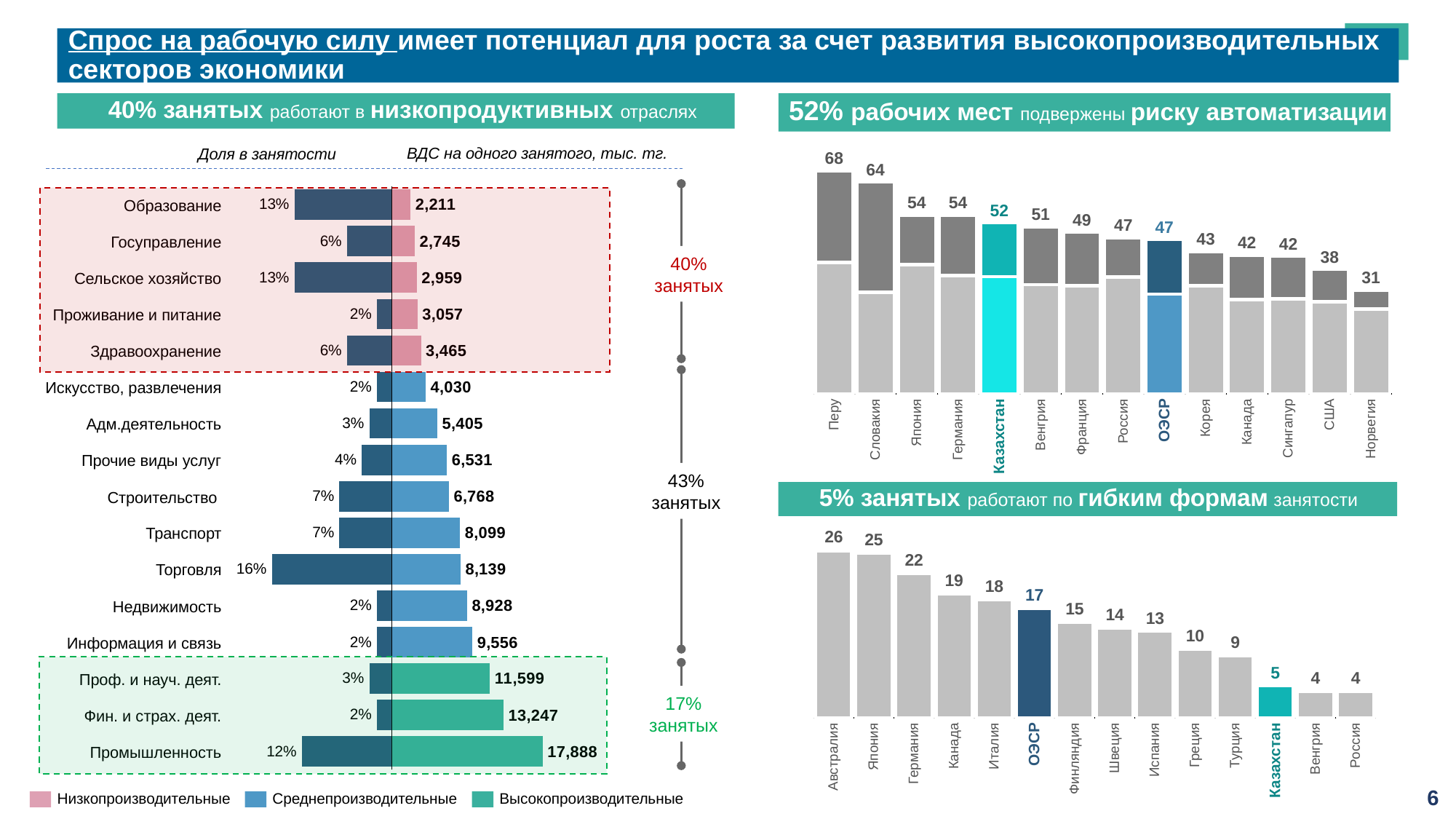
On the chart titled '40% занятых работают в низкопродуктивных отраслях', what is the difference in ВДС на одного занятого between Фин. и страх. деят. and Проф. и науч. деят.? 1,648 On the chart titled '52% рабочих мест подвержены риску автоматизации', what is the value for Казахстан? 52 On the chart titled '40% занятых работают в низкопродуктивных отраслях', which sector has the highest ВДС на одного занятого? Промышленность On the chart titled '52% рабочих мест подвержены риску автоматизации', which country has the highest value? Перу On the chart titled '5% занятых работают по гибким формам занятости', what is the value for ОЭСР? 17 On the chart titled '52% рабочих мест подвержены риску автоматизации', how many countries/regions are shown? 14 On the chart titled '52% рабочих мест подвержены риску автоматизации', what is the difference between Перу and Норвегия? 37 On the chart titled '40% занятых работают в низкопродуктивных отраслях', how many entries does the legend list? 3 On the chart titled '40% занятых работают в низкопродуктивных отраслях', which sector has the lowest ВДС на одного занятого? Образование On the chart titled '5% занятых работают по гибким формам занятости', which is larger, Австралия or Япония? Австралия On the chart titled '40% занятых работают в низкопродуктивных отраслях', what is the ВДС на одного занятого for Промышленность? 17,888 On the chart titled '40% занятых работают в низкопродуктивных отраслях', what is the Доля в занятости for Торговля? 16%